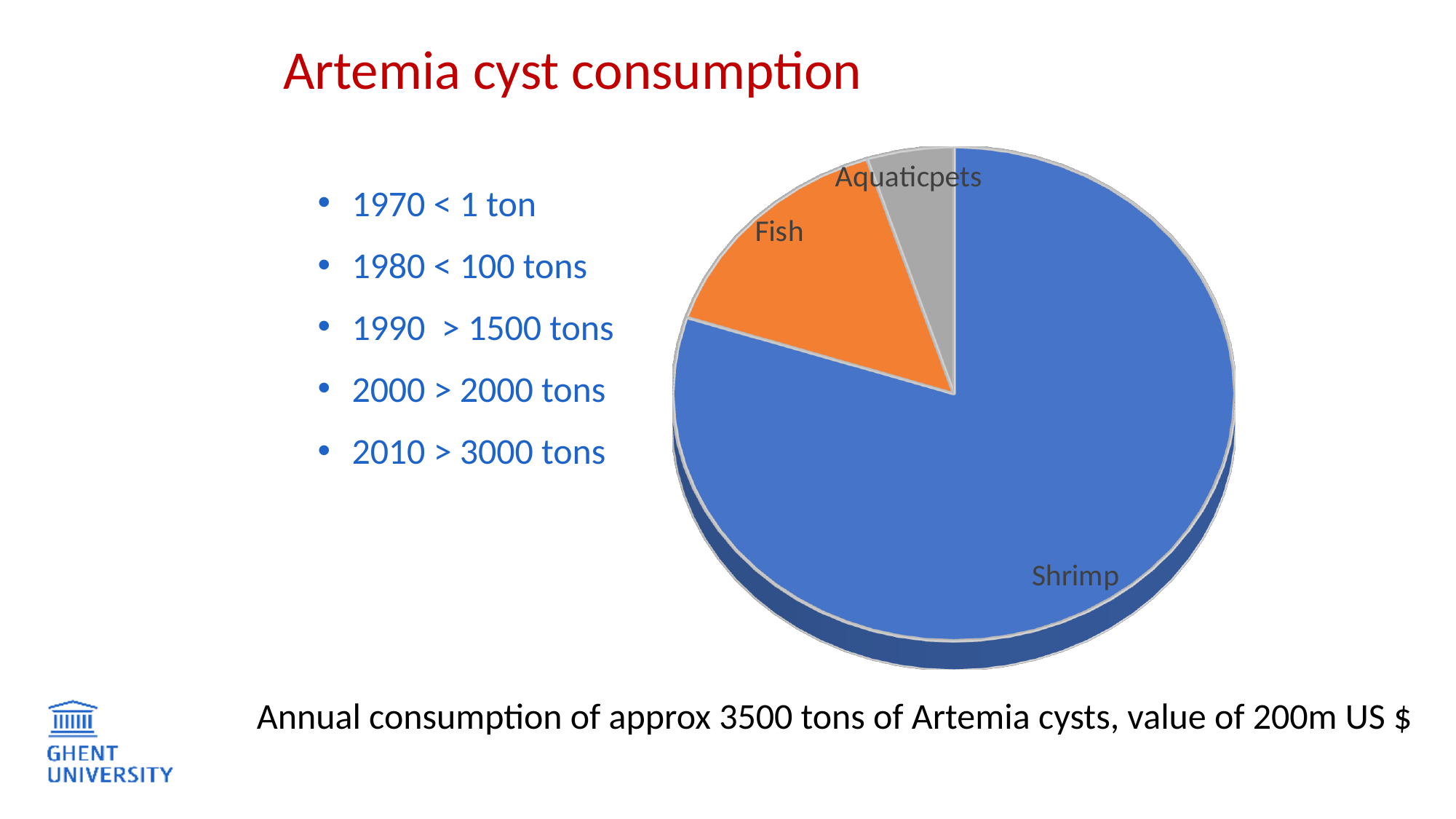
What colour is the Shrimp slice in the pie chart? blue What colour is the Fish slice in the pie chart? orange How many slices does the pie chart have? 3 Which slice of the pie chart is the largest? Shrimp Which slice is larger in the pie chart, Fish or Aquaticpets? Fish What kind of chart is shown on the slide? pie chart Which slice of the pie chart is the smallest? Aquaticpets Does the Shrimp slice take up more or less than half of the pie chart? more Which slice is larger in the pie chart, Shrimp or Fish? Shrimp